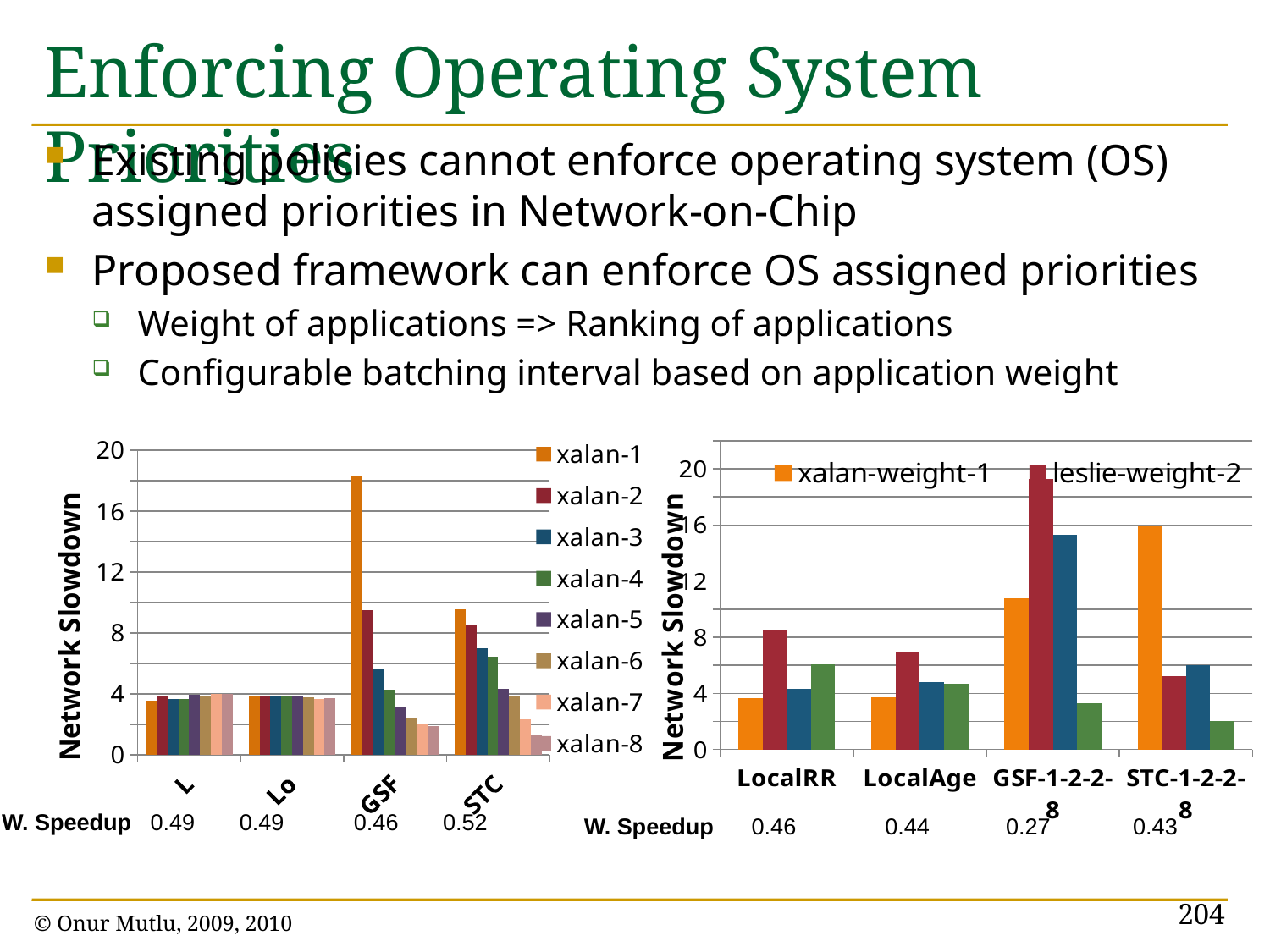
In the left chart, is the xalan-1 value for GSF greater or less than 16? greater In the right chart, is the xalan-weight-1 value for STC-1-2-2-8 greater or less than 12? greater How many series does the legend of the left chart list? 8 In the left chart, is the xalan-1 value for STC greater or less than 8? greater In the right chart, which category contains the tallest bar? GSF-1-2-2-8 How many categories are shown on the x axis of the right chart? 4 What W. Speedup value is printed under STC in the left chart? 0.52 What kind of chart is the left chart on the slide? bar chart In the right chart, which has the larger xalan-weight-1 value, STC-1-2-2-8 or GSF-1-2-2-8? STC-1-2-2-8 In the left chart, which category has the tallest bar? GSF What W. Speedup value is printed under GSF-1-2-2-8 in the right chart? 0.27